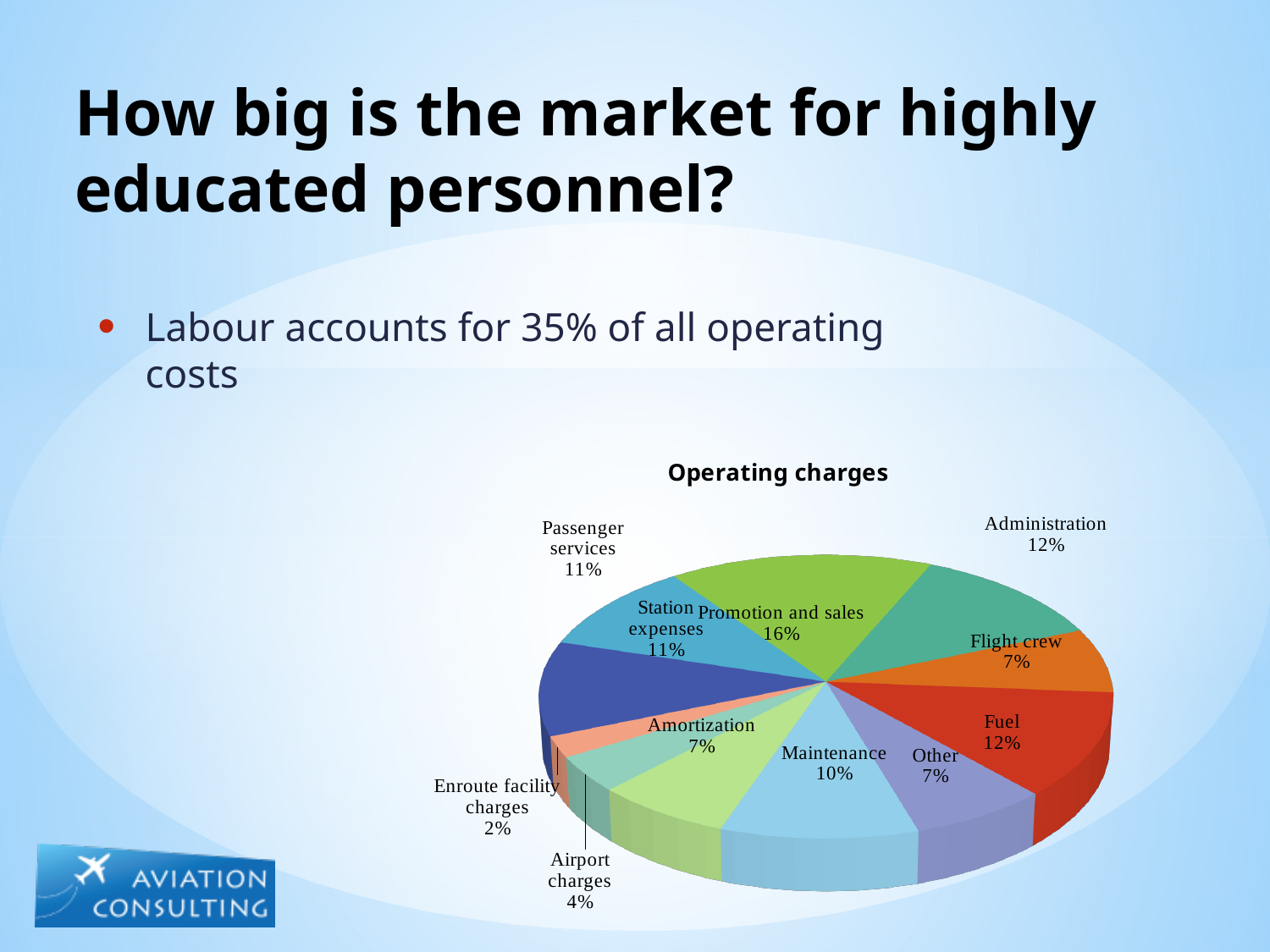
What percentage is shown for Enroute facility charges? 2% What type of chart is shown on the slide? Pie chart How many categories are shown in the pie chart? 11 What is the difference in percentage points between Administration and Flight crew? 5 Which category has the largest share of operating charges? Promotion and sales What share of operating charges is Promotion and sales? 16% Which category has the smallest share of operating charges? Enroute facility charges What is the title of the chart? Operating charges What is the combined share of Station expenses and Passenger services? 22% What percentage of operating charges is Fuel? 12% What is the value shown for Maintenance? 10% Which is larger, Maintenance or Airport charges? Maintenance